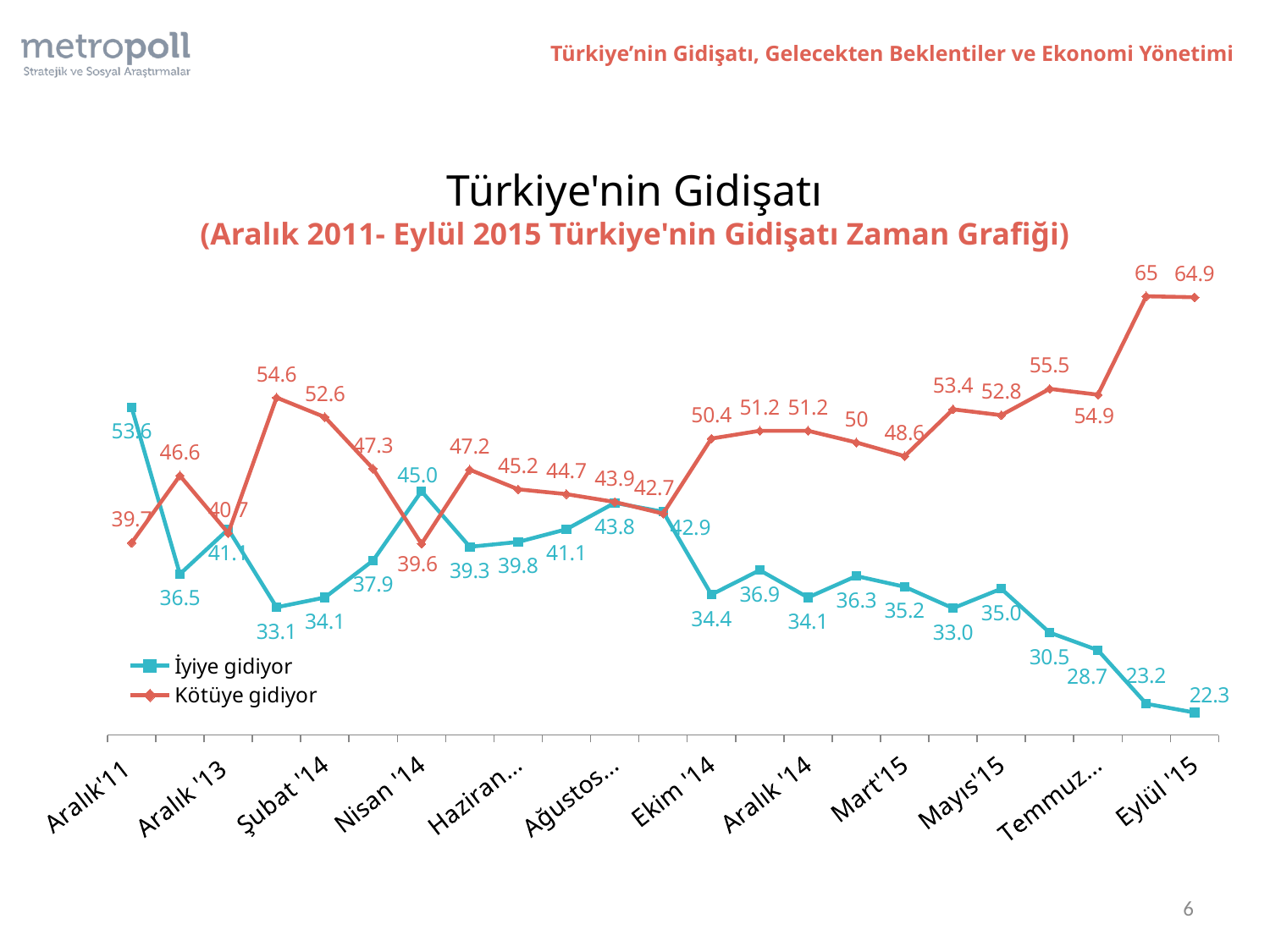
What is the value of the İyiye gidiyor series at Aralık'11? 53.6 What is the value of the Kötüye gidiyor series at Aralık'11? 39.7 What is the highest value shown for the Kötüye gidiyor series? 65 Does the İyiye gidiyor series generally rise or fall from Ekim '14 to Eylül '15? fall What is the value of the İyiye gidiyor series at Eylül '15? 22.3 What kind of chart is shown on the slide? line chart What is the lowest value shown for the İyiye gidiyor series? 22.3 What are the two series named in the legend? İyiye gidiyor and Kötüye gidiyor How many series does the legend list? 2 At Eylül '15, which series has the larger value, İyiye gidiyor or Kötüye gidiyor? Kötüye gidiyor What is the value of the Kötüye gidiyor series at Eylül '15? 64.9 What is the difference between the Kötüye gidiyor and İyiye gidiyor values at Eylül '15? 42.6